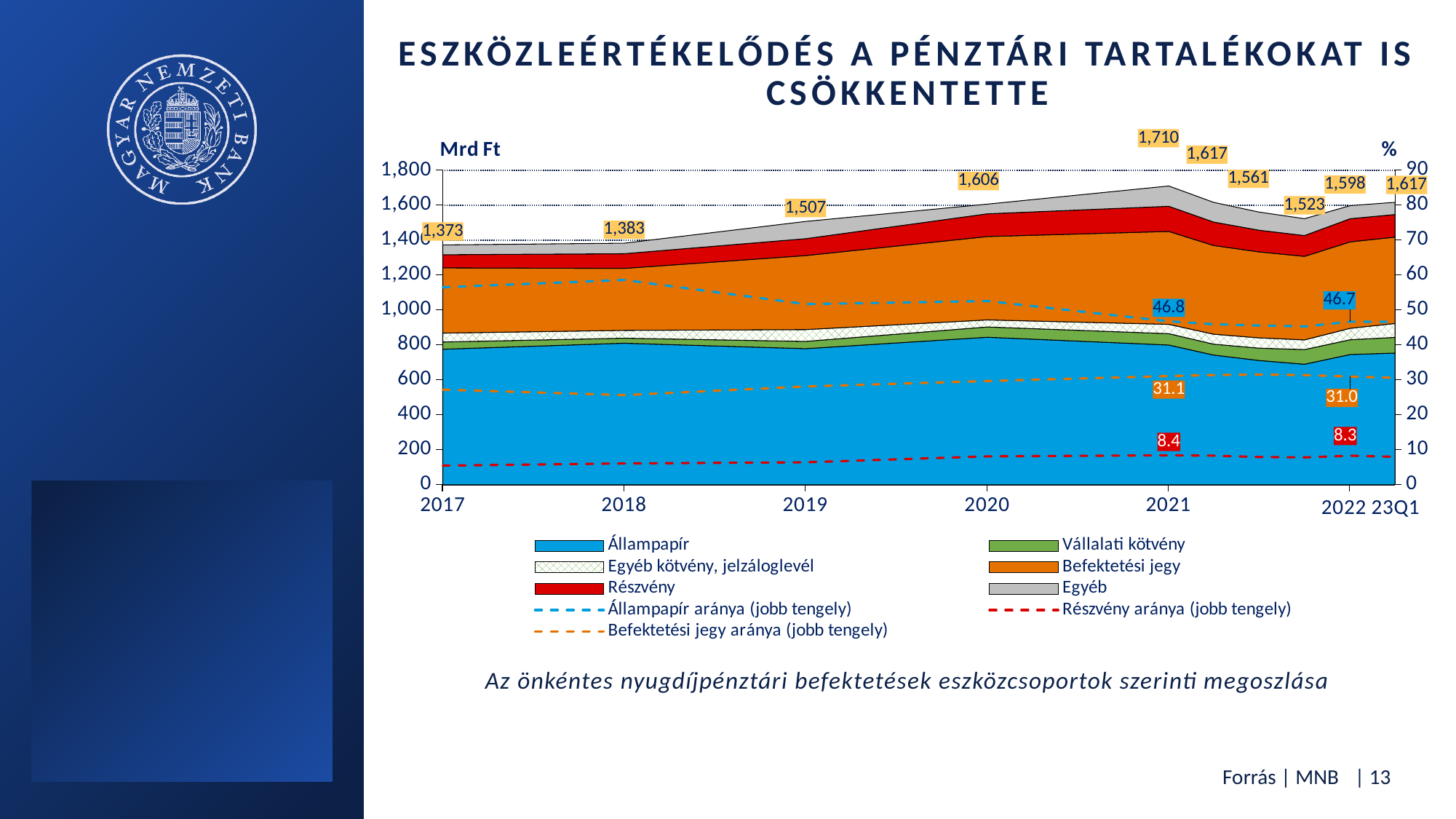
Which year has the highest total value labelled on the chart? 2021 Which labelled point has the lowest total value? 2017 What is the total value shown for 2021? 1,710 What unit is shown on the left axis of the chart? Mrd Ft How many series does the legend list? 9 What is the total value shown for 2020? 1,606 What is the difference between the total values for 2021 and 2017? 337 What is the total value of the voluntary pension fund investments shown for 2017? 1,373 What is the difference between the total values for 2019 and 2018? 124 What is the value of 'Állampapír aránya (jobb tengely)' labelled at 2021? 46.8